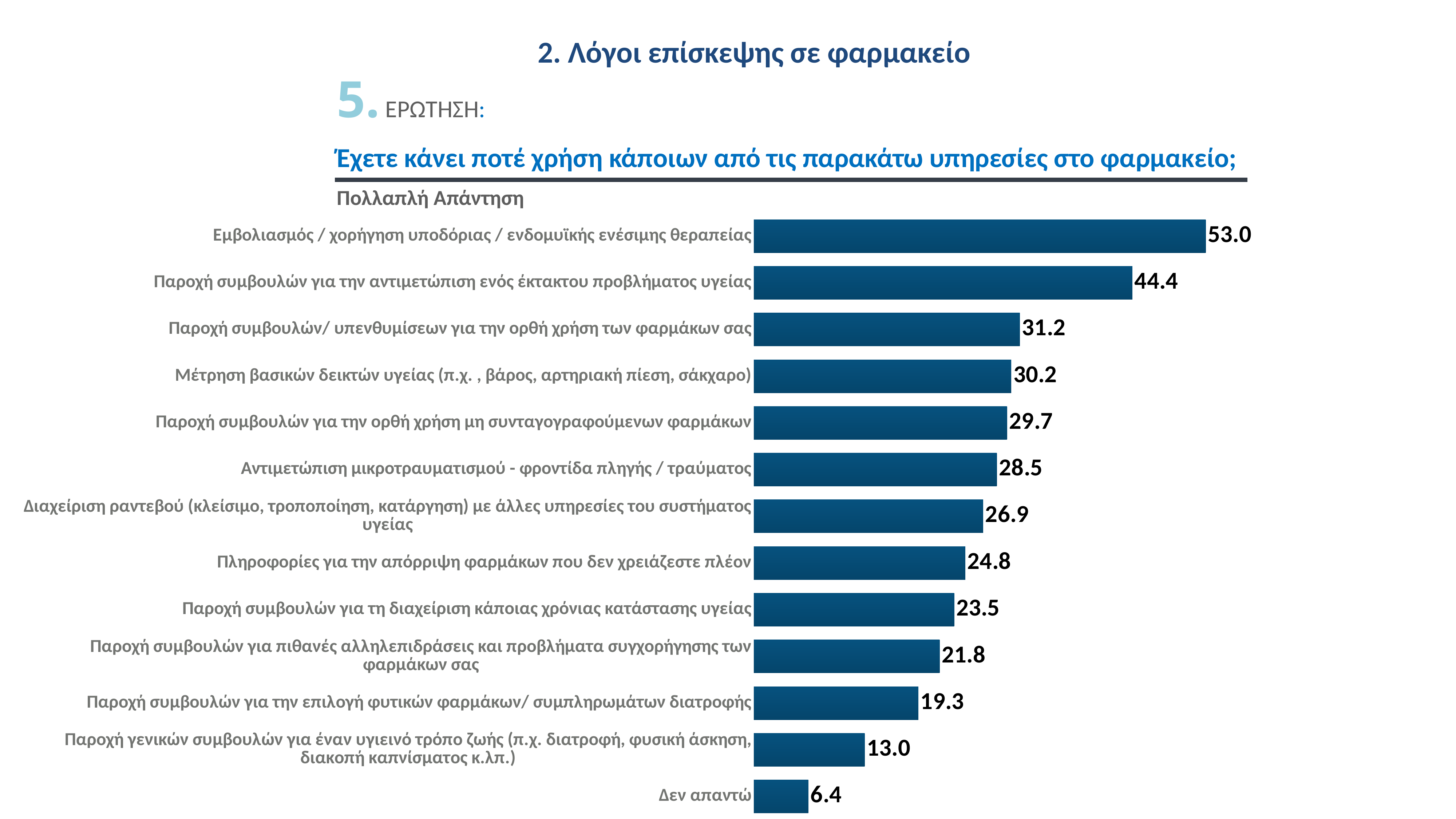
How many categories are shown in the chart? 13 Which category has the lowest value? Δεν απαντώ Which is larger: the value for "Αντιμετώπιση μικροτραυματισμού - φροντίδα πληγής / τραύματος" or the value for "Παροχή συμβουλών για πιθανές αλληλεπιδράσεις και προβλήματα συγχορήγησης των φαρμάκων σας"? Αντιμετώπιση μικροτραυματισμού - φροντίδα πληγής / τραύματος What is the value for "Μέτρηση βασικών δεικτών υγείας (π.χ. , βάρος, αρτηριακή πίεση, σάκχαρο)"? 30.2 Which category has the highest value? Εμβολιασμός / χορήγηση υποδόριας / ενδομυϊκής ενέσιμης θεραπείας What is the value for "Εμβολιασμός / χορήγηση υποδόριας / ενδομυϊκής ενέσιμης θεραπείας"? 53.0 What is the value for "Δεν απαντώ"? 6.4 What is the question text shown above the chart? Έχετε κάνει ποτέ χρήση κάποιων από τις παρακάτω υπηρεσίες στο φαρμακείο; What is the difference between the values for "Πληροφορίες για την απόρριψη φαρμάκων που δεν χρειάζεστε πλέον" and "Παροχή συμβουλών για τη διαχείριση κάποιας χρόνιας κατάστασης υγείας"? 1.3 What is the difference between the values for "Εμβολιασμός / χορήγηση υποδόριας / ενδομυϊκής ενέσιμης θεραπείας" and "Παροχή συμβουλών για την αντιμετώπιση ενός έκτακτου προβλήματος υγείας"? 8.6 What kind of chart is shown on the slide? Bar chart What is the value for "Παροχή συμβουλών για την επιλογή φυτικών φαρμάκων/ συμπληρωμάτων διατροφής"? 19.3